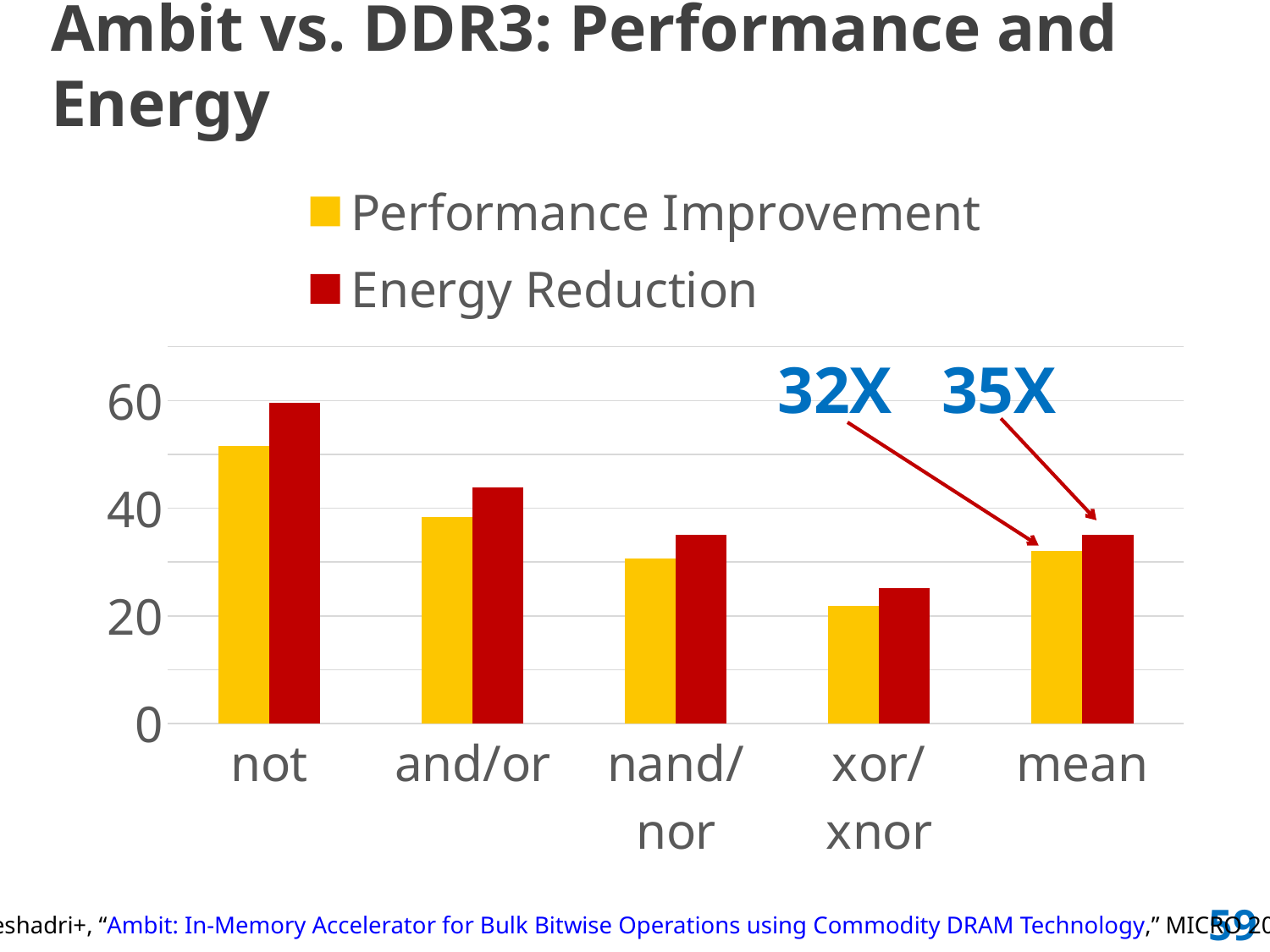
What kind of chart is shown on the slide? bar chart What is the Energy Reduction value for the mean category? 35X What is the difference between the Energy Reduction and Performance Improvement values for the mean category? 3X How many categories are shown on the x axis? 5 Is the Energy Reduction value for not greater or less than 40? greater How many series does the legend list? 2 For the mean category, which is larger: Performance Improvement or Energy Reduction? Energy Reduction Do the Performance Improvement values rise or fall from not to xor/xnor? fall Which category has the lowest Energy Reduction? xor/xnor Which category has the highest Performance Improvement? not What is the Performance Improvement value for the mean category? 32X Is the Performance Improvement value for xor/xnor greater or less than 40? less